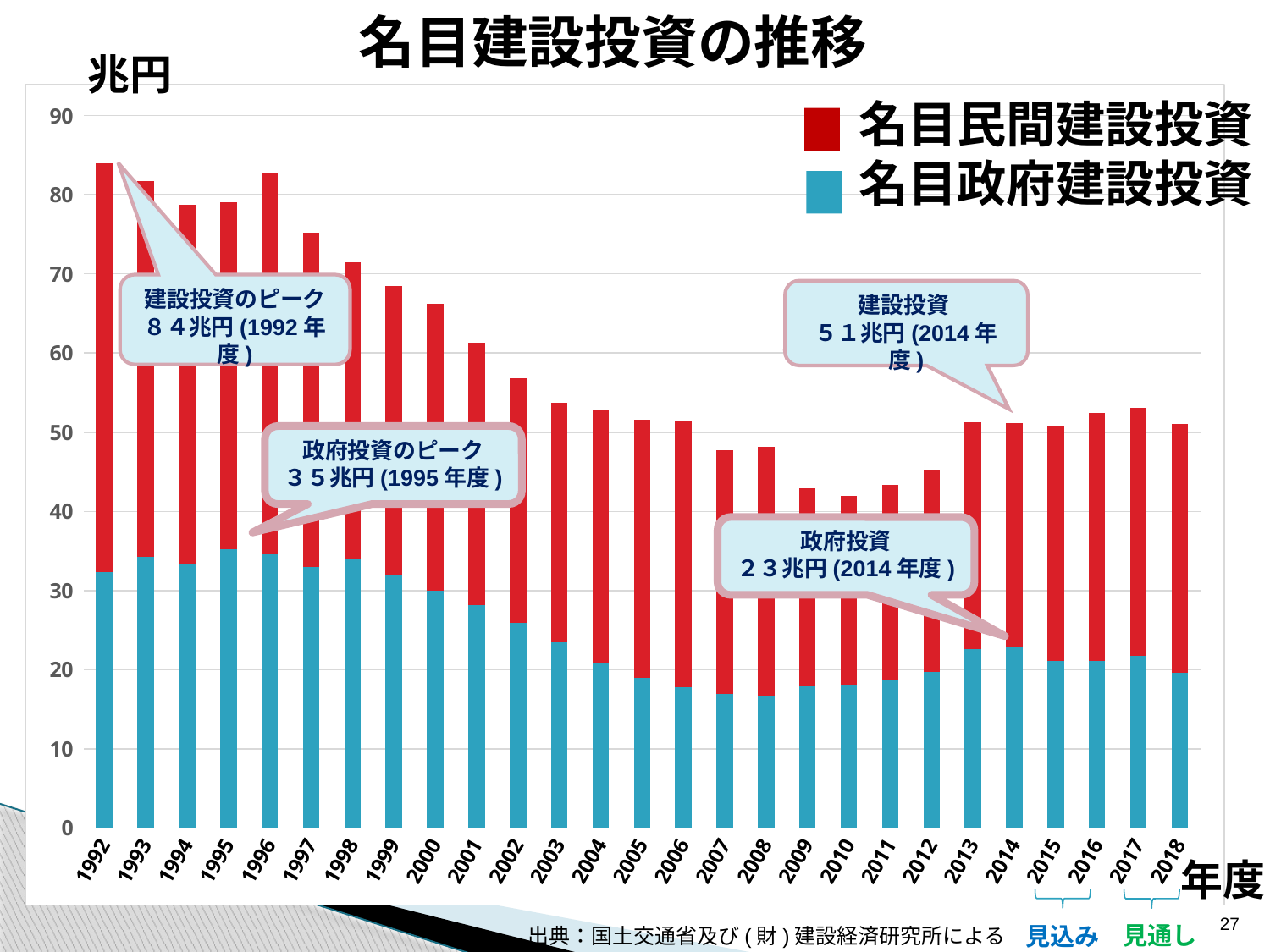
What kind of chart is shown on the slide? Stacked bar chart By how much did total construction investment fall from its 1992 peak (84兆円) to 2014 (51兆円)? 33兆円 What is the government construction investment value for 2014 shown in the callout? 23兆円 How many fiscal years are shown on the x axis? 27 Is the total construction investment for 2010 greater or less than 50? less Is the government construction investment (blue segment) for 2007 greater or less than 20? less Is the total construction investment for 1996 greater or less than 80? greater Which fiscal year has the highest total construction investment? 1992 How many series does the legend list? 2 What is the total construction investment for fiscal year 2014 according to the callout? 51兆円 According to the callout, what was government construction investment (名目政府建設投資) at its peak in 1995? 35兆円 What is the peak value of total construction investment shown in the callout, and in which fiscal year? 84兆円 (1992年度)